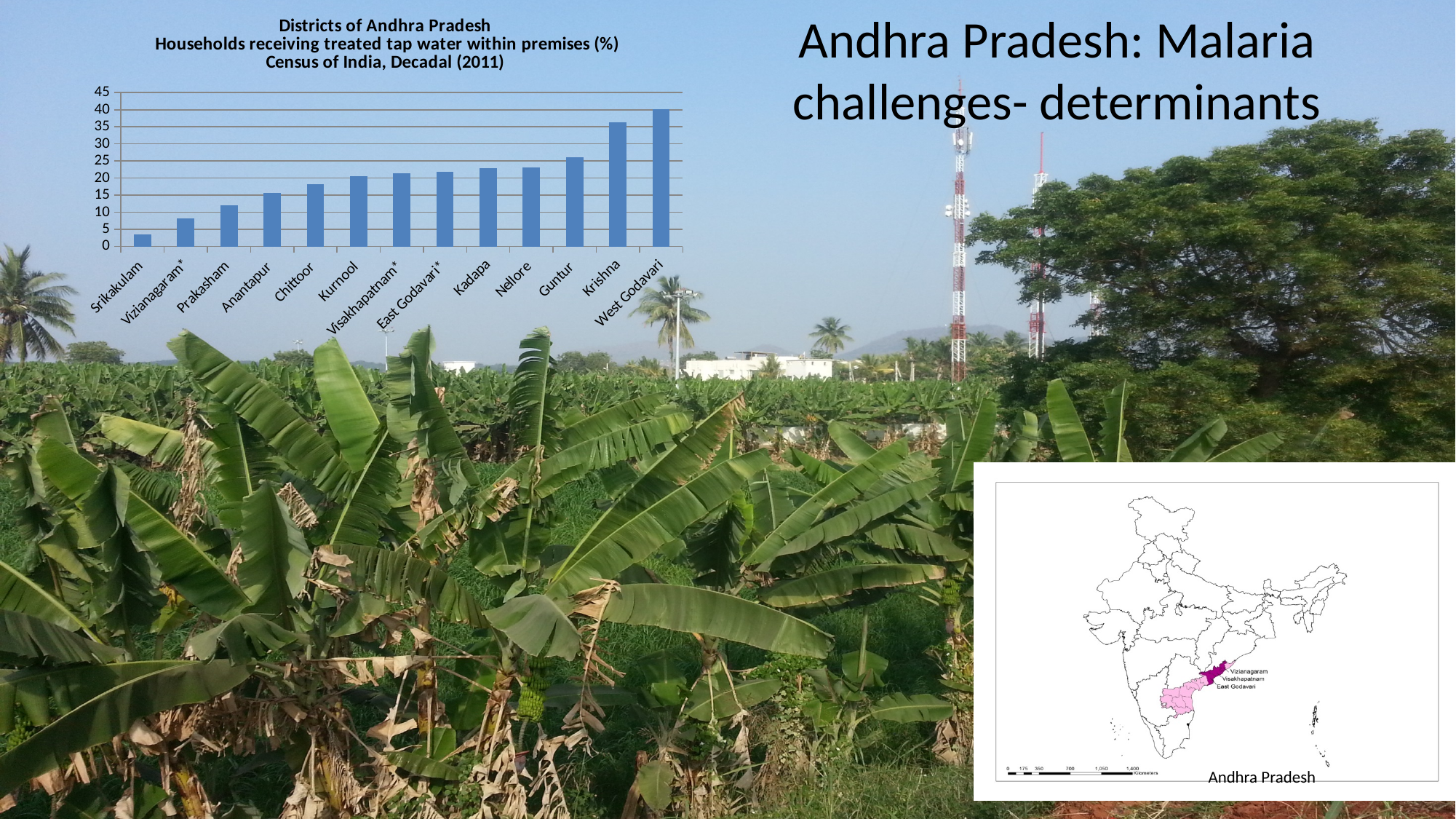
Which district has the highest percentage of households receiving treated tap water within premises? West Godavari Which district has the larger value, Krishna or Guntur? Krishna According to the chart title, what is the data source and year of the chart? Census of India, Decadal (2011) How many districts are shown on the x axis of the chart? 13 What kind of chart is shown on the slide? bar chart Is the value for Chittoor greater or less than 20? less Is the value for Krishna greater or less than 30? greater Is the value for Guntur greater or less than 30? less Which district has the lowest percentage of households receiving treated tap water within premises? Srikakulam Do the bar values rise or fall from left to right along the x axis? rise Which district has the larger value, Prakasham or Anantapur? Anantapur